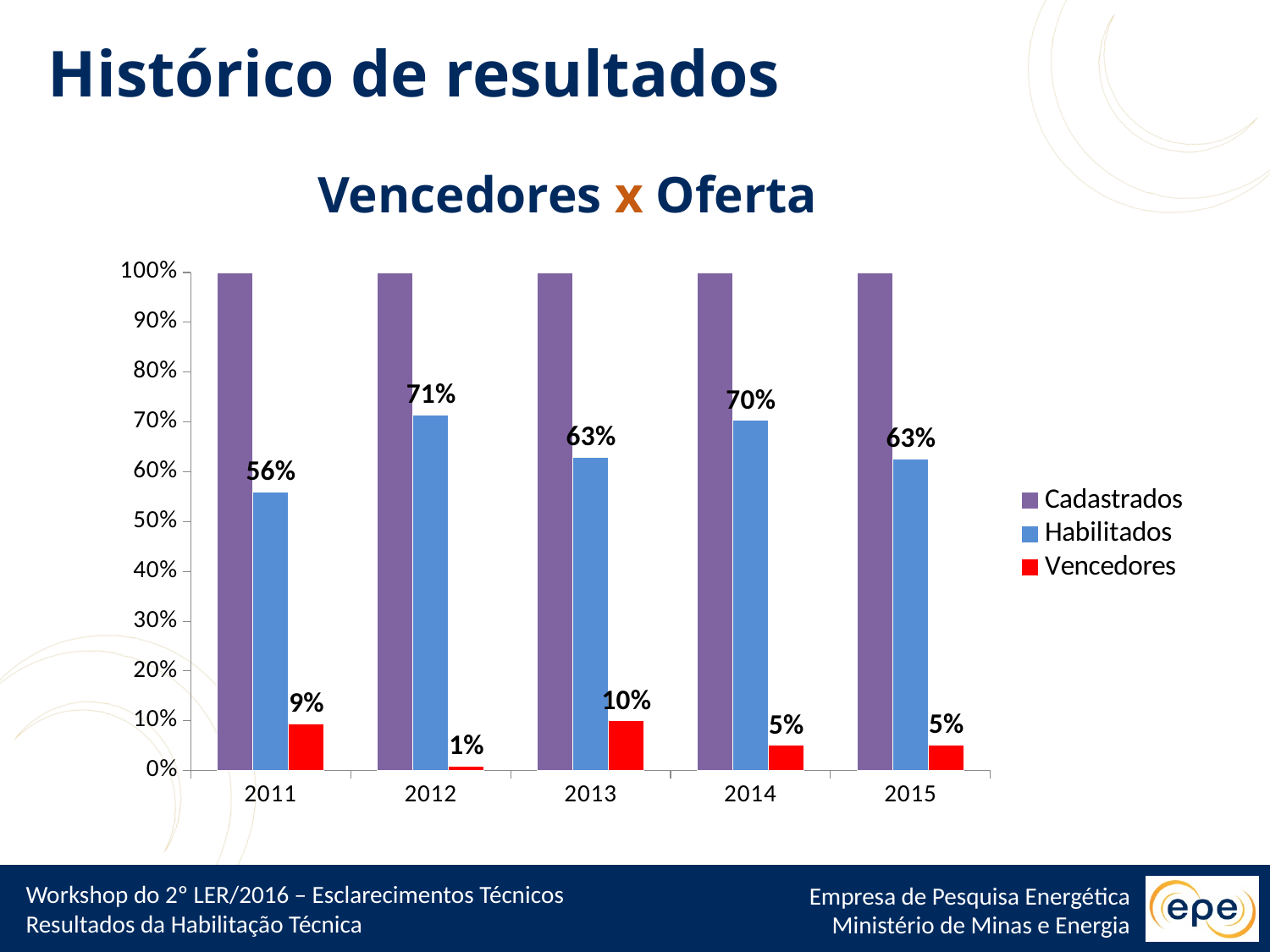
What is the Vencedores value for 2013? 10% What kind of chart is shown? bar chart Which year has the highest Habilitados value? 2012 What is the Habilitados value for 2011? 56% What is the Vencedores value for 2012? 1% Which is larger, the Vencedores value for 2011 or for 2014? 2011 How many series does the legend list? 3 How many years are shown on the x axis? 5 What is the Habilitados value for 2012? 71% Which year has the lowest Vencedores value? 2012 Is the Cadastrados value for 2013 greater or less than 90%? greater What is the difference between the Habilitados values for 2012 and 2011? 15%